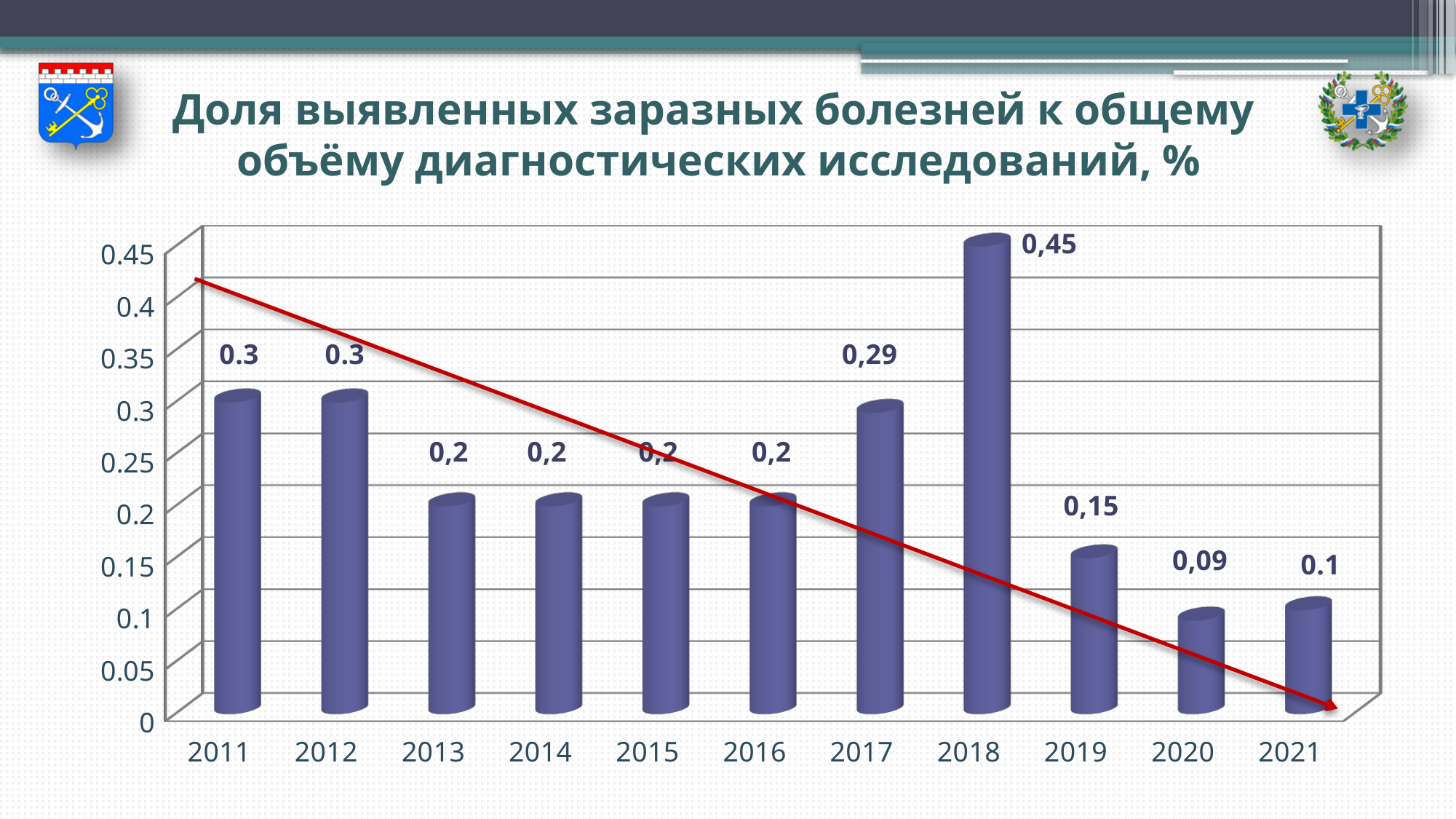
Which is larger, the value for 2019 or the value for 2021? 2019 What direction does the red trend line drawn across the chart indicate? downward (falling) What is the difference between the values for 2011 and 2021? 0.2 Which year has the highest value? 2018 What kind of chart is shown on the slide? bar chart What is the value for 2018? 0,45 How many years are shown on the x axis? 11 What is the difference between the values for 2018 and 2017? 0,16 What is the value for 2020? 0,09 What is the value for 2011? 0.3 What is the value for 2017? 0,29 Which year has the lowest value? 2020